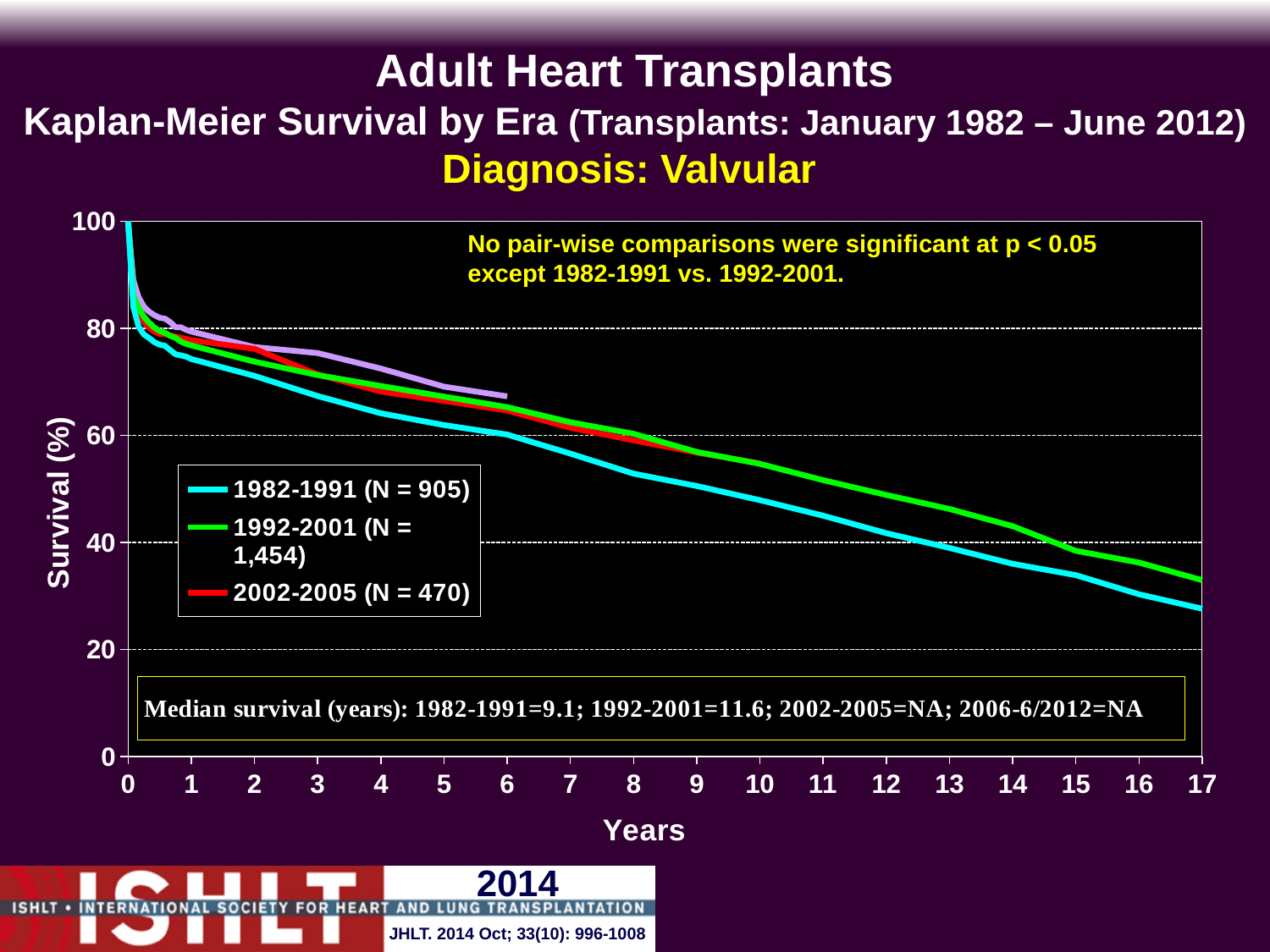
What is the median survival in years for the 1992-2001 era, as stated on the slide? 11.6 Which era shown in the legend has the lowest survival curve across the chart? 1982-1991 What is the label of the y axis? Survival (%) Is the survival value for the 2002-2005 era at 3 years greater or less than 60? greater Is the survival value for the 1992-2001 era at 5 years greater or less than 60? greater Is the survival value for the 1982-1991 era at 10 years greater or less than 60? less How many series does the chart legend list? 3 At 10 years, which era has the higher survival: 1982-1991 or 1992-2001? 1992-2001 What is the N for the 1982-1991 era in the legend? 905 What kind of chart is shown on the slide? line chart Do the survival curves rise or fall as the years increase along the x axis? fall